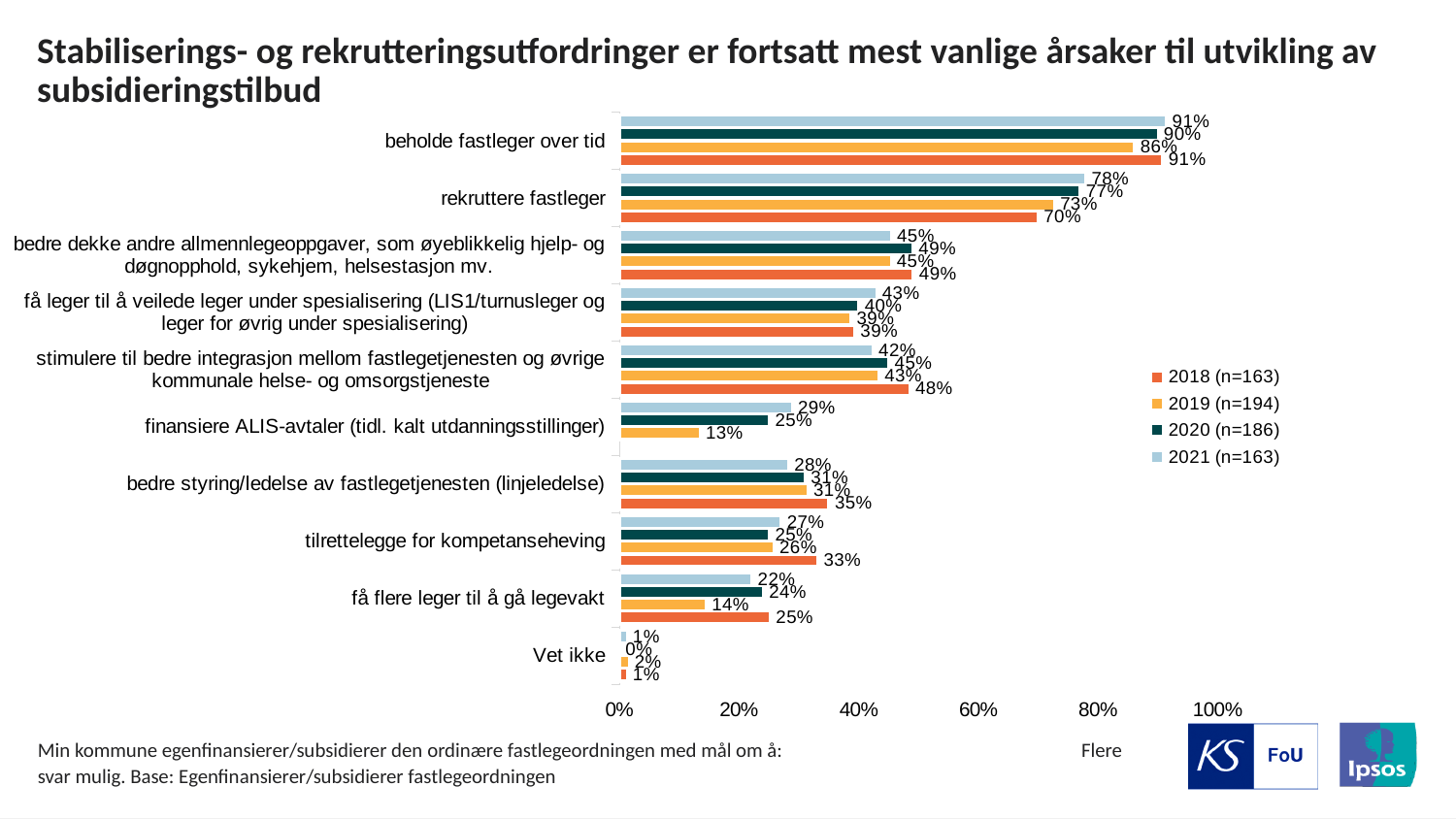
What is the value for 'få flere leger til å gå legevakt' in the 2018 (n=163) series? 25% Which category has the lowest value in the 2021 (n=163) series? Vet ikke What is the value for 'rekruttere fastleger' in the 2021 (n=163) series? 78% What kind of chart is shown on the slide? bar chart How many series does the legend list? 4 What is the difference between the 2018 (n=163) and 2021 (n=163) values for 'tilrettelegge for kompetanseheving'? 6% For 'rekruttere fastleger', which is larger: the 2018 (n=163) value or the 2021 (n=163) value? 2021 (n=163) How many categories are shown on the chart? 10 Which category has the highest value in the 2018 (n=163) series? beholde fastleger over tid What is the value for 'finansiere ALIS-avtaler (tidl. kalt utdanningsstillinger)' in the 2019 (n=194) series? 13% What is the value for 'bedre styring/ledelse av fastlegetjenesten (linjeledelse)' in the 2018 (n=163) series? 35% Which series is shown in light blue in the legend? 2021 (n=163)